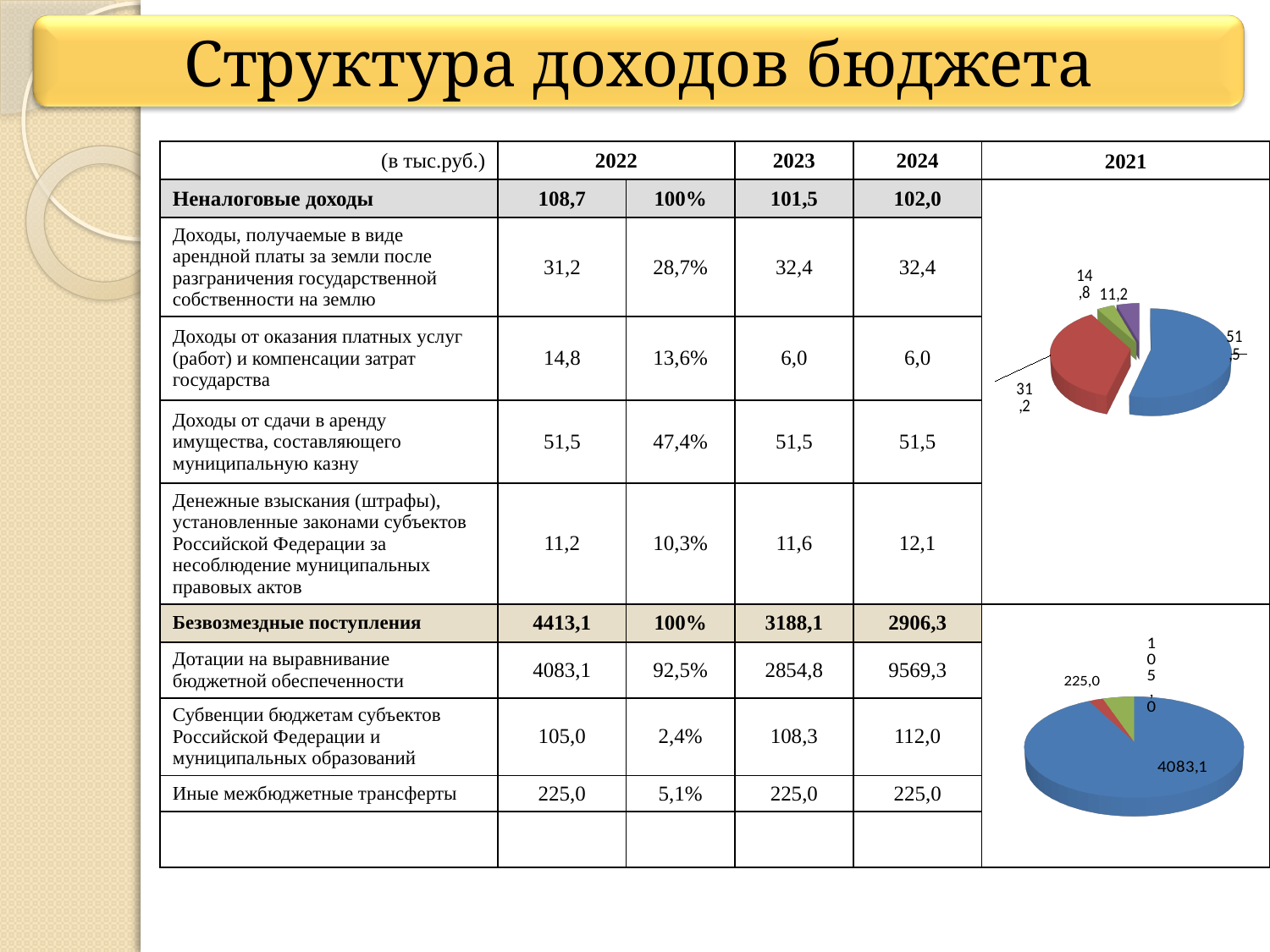
What kind of chart is the upper chart on the right side of the slide (for 2021)? pie chart In the upper pie chart, which is larger: the slice labelled 31,2 or the slice labelled 14,8? 31,2 In the upper pie chart, what is the difference between the slice labelled 51,5 and the slice labelled 31,2? 20,3 In the lower pie chart, what is the value of the largest slice? 4083,1 In the lower pie chart, what is the difference between the slice labelled 4083,1 and the slice labelled 225,0? 3858,1 How many slices does the lower pie chart have? 3 In the upper pie chart, what is the value of the largest slice? 51,5 How many pie charts are shown on the slide? 2 How many slices does the upper pie chart have? 4 In the lower pie chart, what is the value of the smallest slice? 105,0 What colour is the largest slice in the lower pie chart? blue